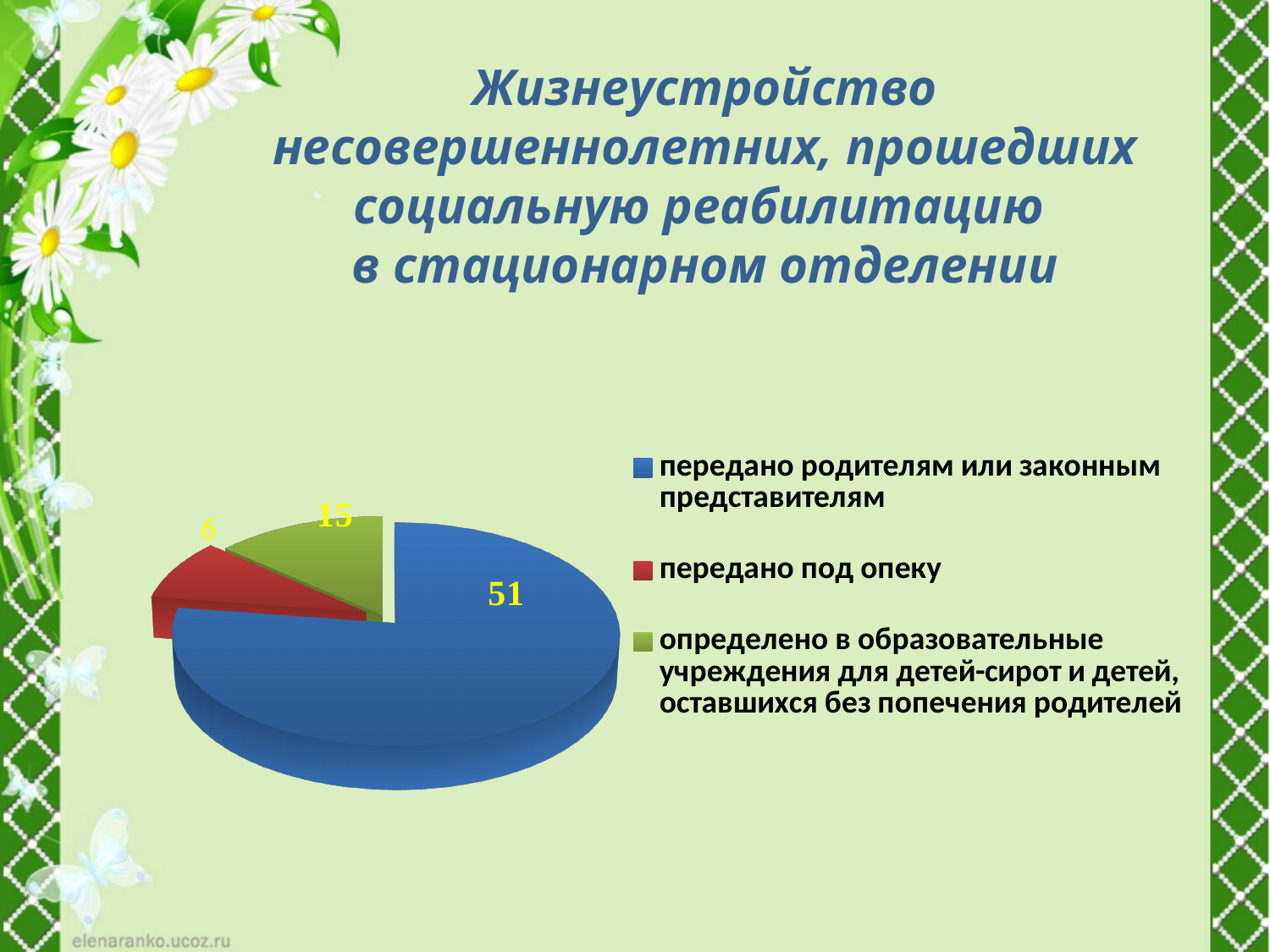
How many slices does the pie chart have? 3 Which category has the smallest slice of the pie? передано под опеку What is the value for "передано под опеку"? 6 Which category has the largest slice of the pie? передано родителям или законным представителям How many entries does the legend list? 3 Which is larger: the value for "передано под опеку" or the value for "определено в образовательные учреждения для детей-сирот и детей, оставшихся без попечения родителей"? определено в образовательные учреждения для детей-сирот и детей, оставшихся без попечения родителей What colour is the slice for "передано под опеку"? red What is the difference between the value for "передано родителям или законным представителям" and the value for "определено в образовательные учреждения для детей-сирот и детей, оставшихся без попечения родителей"? 36 What is the total of all the slices in the pie chart? 72 What is the value for "передано родителям или законным представителям"? 51 What kind of chart is shown on the slide? pie chart What is the value for "определено в образовательные учреждения для детей-сирот и детей, оставшихся без попечения родителей"? 15